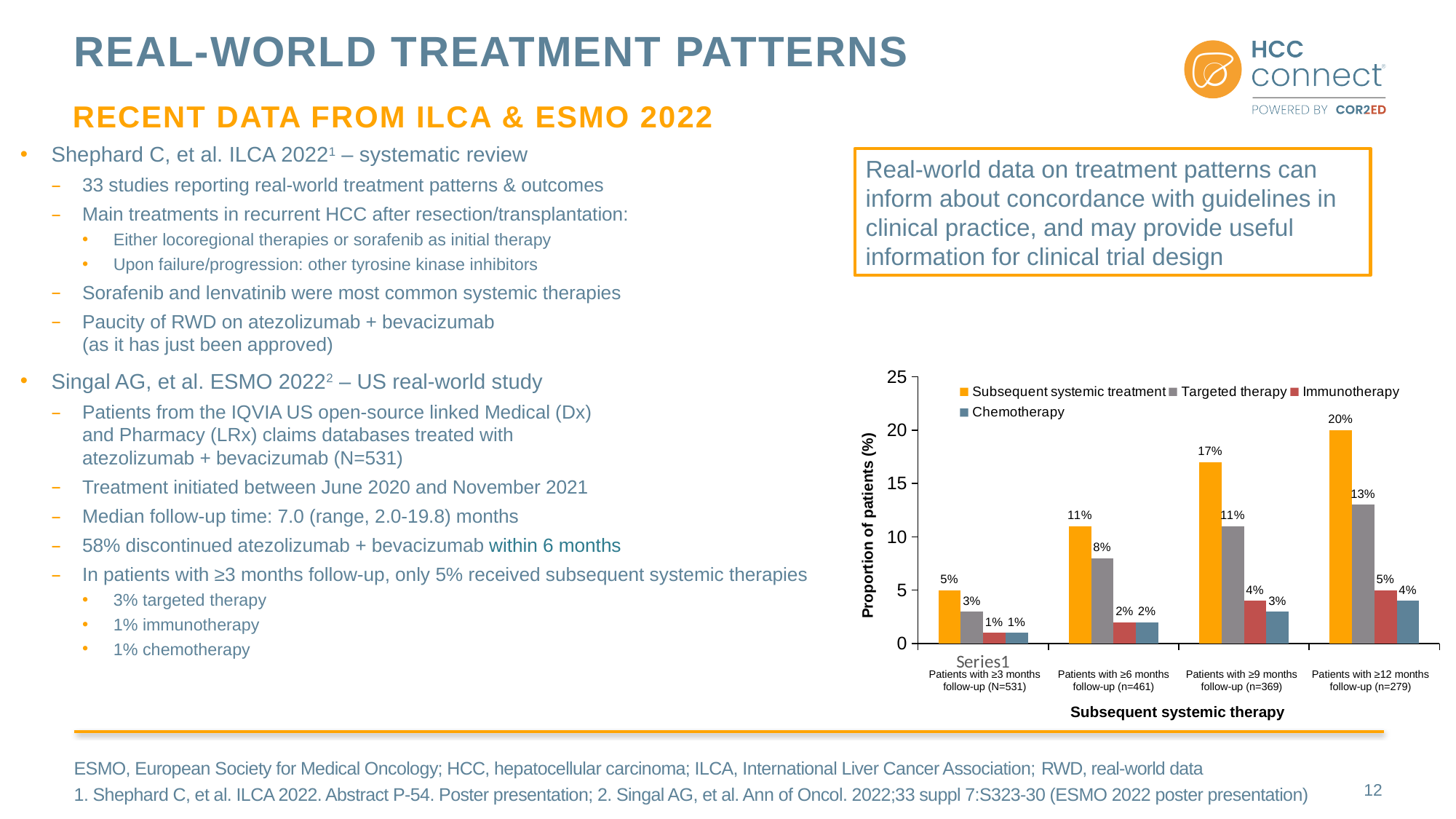
What is the value for Immunotherapy in patients with ≥9 months follow-up? 4% How many series does the chart legend list? 4 Which follow-up category has the lowest value for Targeted therapy? Patients with ≥3 months follow-up (N=531) Which follow-up category has the highest value for Subsequent systemic treatment? Patients with ≥12 months follow-up (n=279) How many follow-up categories are shown on the x axis of the chart? 4 What kind of chart is shown on the slide? Bar chart What is the label of the y axis of the chart? Proportion of patients (%) Does the value for Subsequent systemic treatment rise or fall as follow-up duration increases along the x axis? Rise Which is larger in patients with ≥12 months follow-up: Immunotherapy or Chemotherapy? Immunotherapy What is the value for Subsequent systemic treatment in patients with ≥12 months follow-up? 20% What is the value for Targeted therapy in patients with ≥6 months follow-up? 8% What is the difference between Subsequent systemic treatment and Targeted therapy in patients with ≥9 months follow-up? 6%